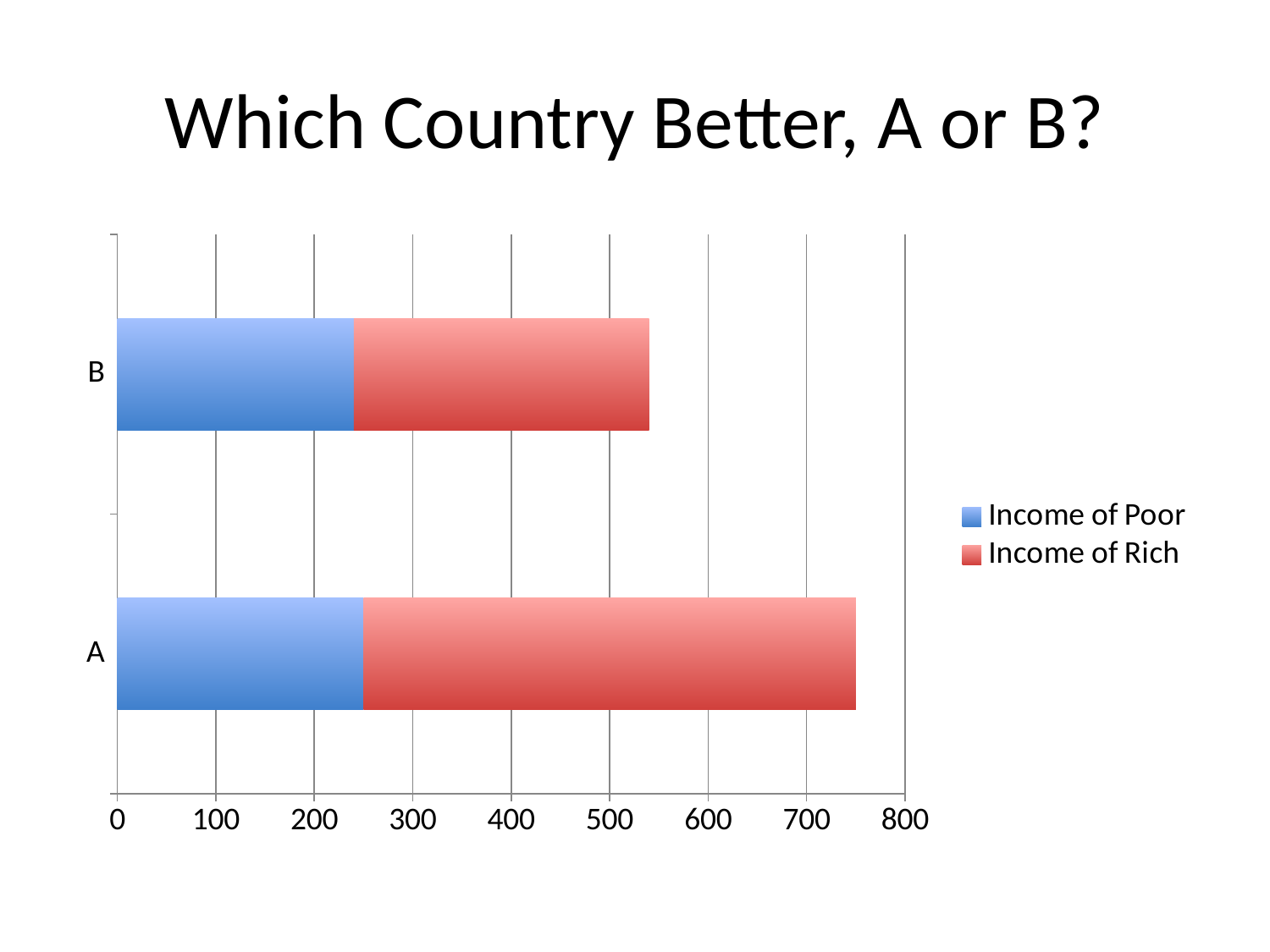
What is the title of the slide? Which Country Better, A or B? Is the Income of Poor value for country A greater or less than 200? greater Is the total bar length for country A greater or less than 700? greater Which country has the longer total bar, A or B? A How many countries (categories) are plotted on the chart? 2 Is the total bar length for country B greater or less than 500? greater Which series is shown in red? Income of Rich What kind of chart is shown on the slide? stacked bar chart How many series does the legend list? 2 Which country has the larger Income of Rich segment, A or B? A Which country has the shorter total bar, A or B? B